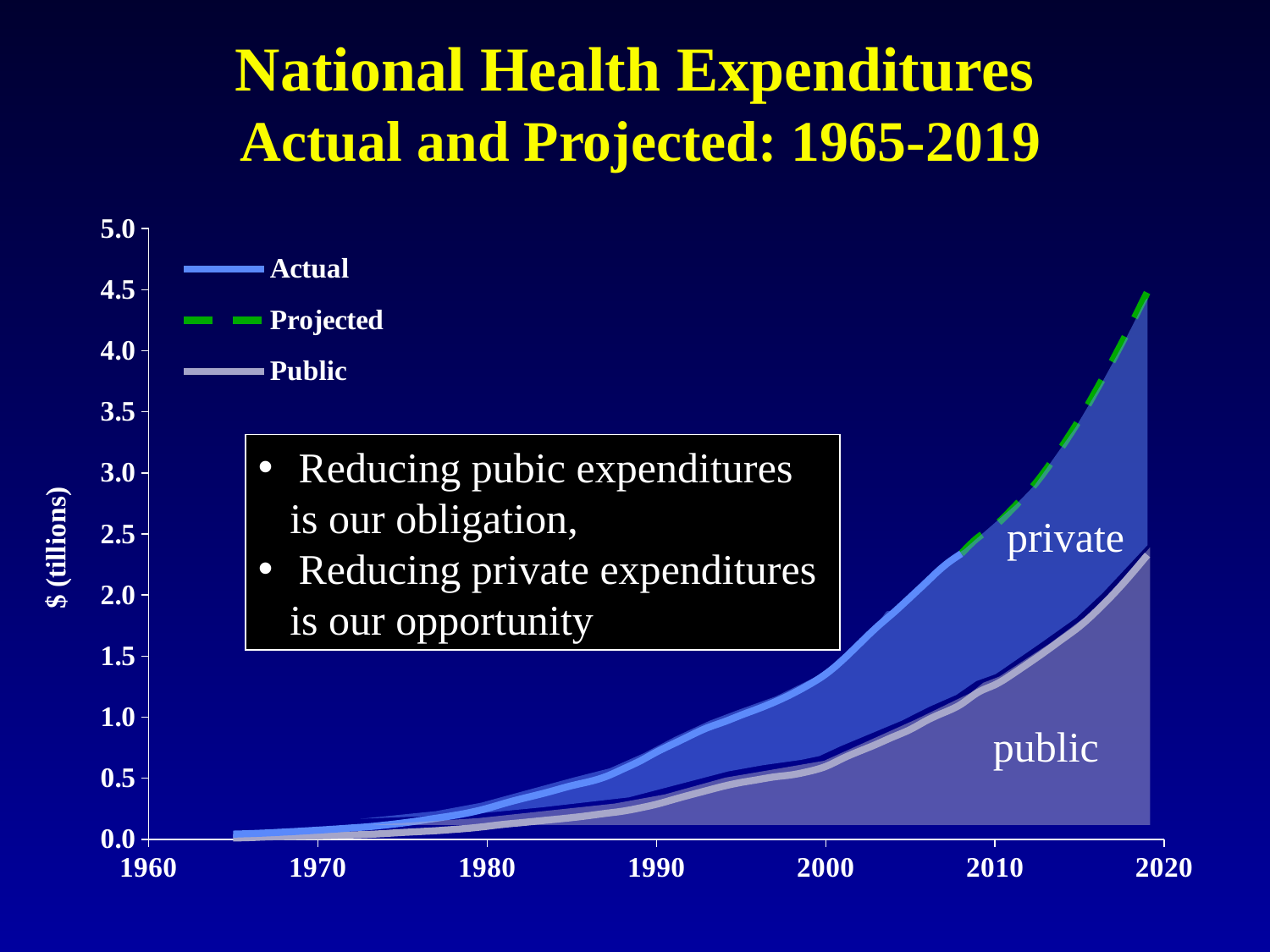
What is the highest value shown on the y axis? 5.0 Is the Actual value in 1990 greater or less than 0.5? greater Is the Actual value in 2000 greater or less than 1.0? greater Is the Public value in 1990 greater or less than 0.5? less What is the y-axis label of the chart? $ (tillions) How many series does the legend list? 3 What are the three series named in the legend? Actual, Projected, Public In 2000, which is larger, the Actual value or the Public value? Actual Do national health expenditures rise or fall over time along the x axis? rise